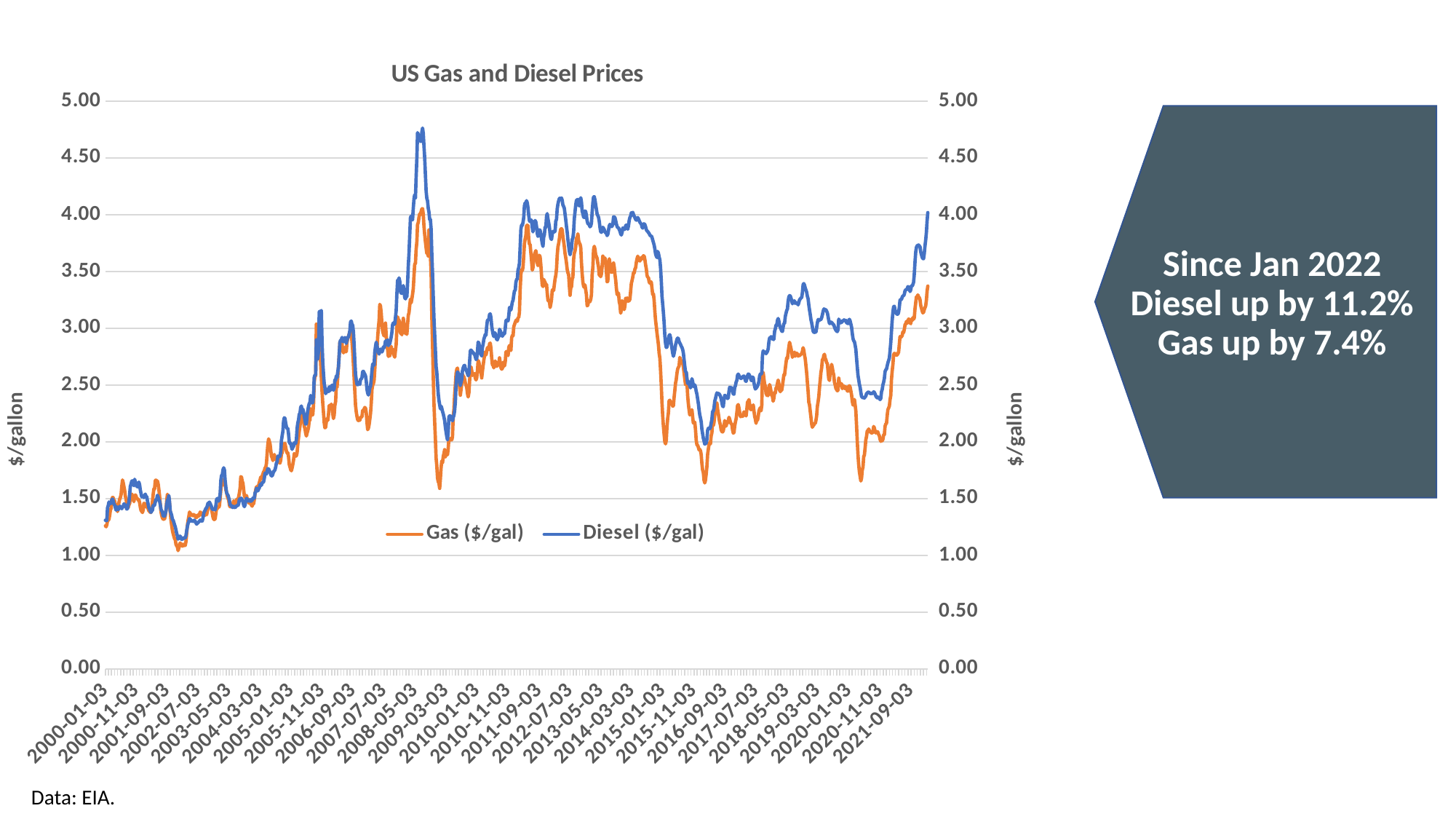
Is the lowest value of the Gas series around 2002 greater or less than 1.50? less What kind of chart is shown on the slide? line chart Is the peak value of the Diesel series around 2008 greater or less than 4.50? greater How many series does the legend list? 2 Do prices generally rise or fall from mid-2014 to early 2016? fall What is the title of the chart? US Gas and Diesel Prices Do prices generally rise or fall from 2000 to mid-2008? rise Is the value of the Gas series at the right end of the chart (2022) greater or less than 3.00? greater Which series reaches the highest value anywhere on the chart, Gas or Diesel? Diesel ($/gal) What is the label on the vertical axis of the chart? $/gallon At the right end of the chart, which series is higher, Gas or Diesel? Diesel ($/gal)